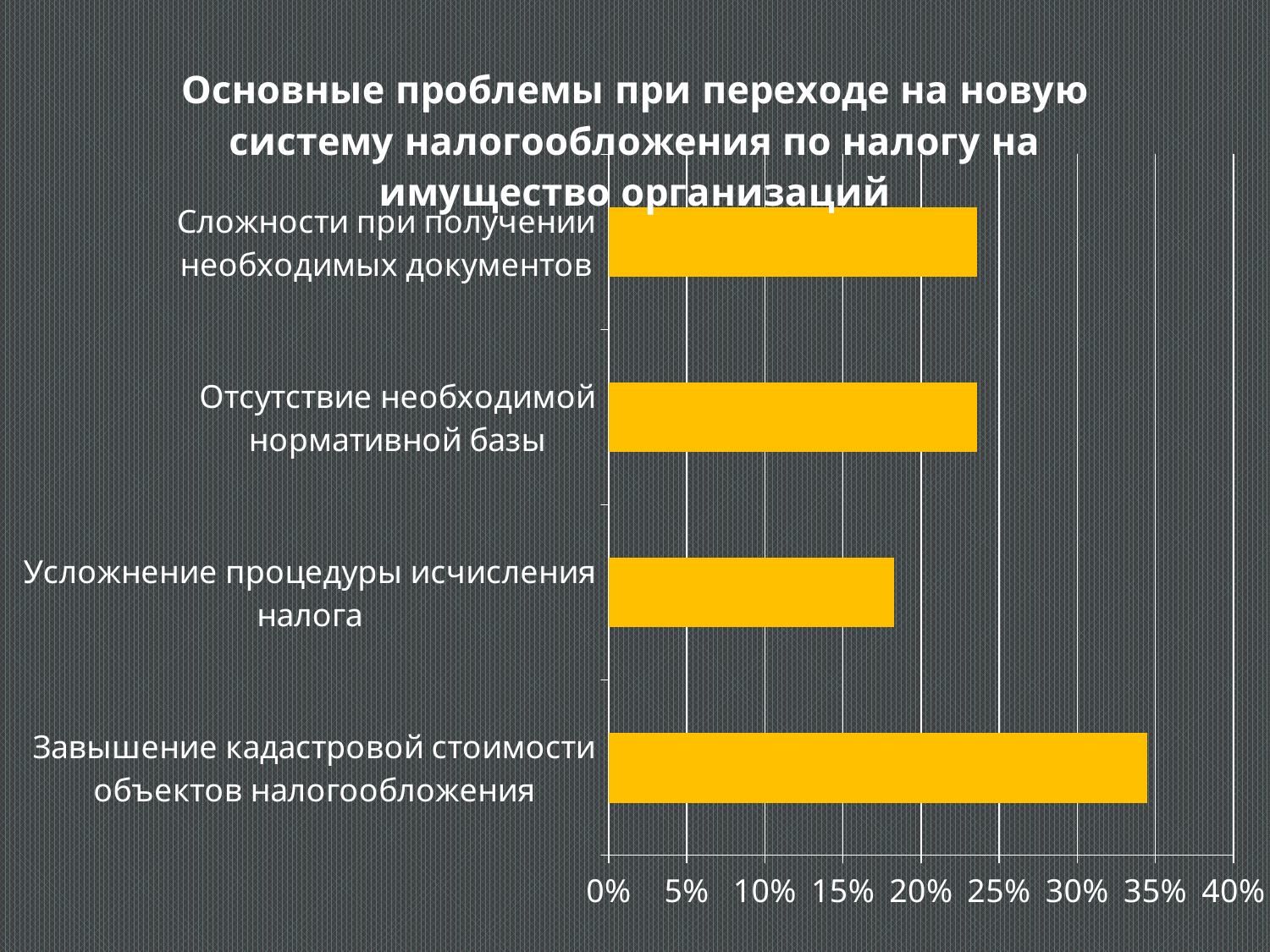
Which is larger: the value for Отсутствие необходимой нормативной базы or the value for Усложнение процедуры исчисления налога? Отсутствие необходимой нормативной базы What kind of chart is shown on the slide? bar chart What is the title of the chart? Основные проблемы при переходе на новую систему налогообложения по налогу на имущество организаций Is the value for Сложности при получении необходимых документов greater or less than 20%? greater Is the value for Усложнение процедуры исчисления налога greater or less than 20%? less Which category has the lowest value? Усложнение процедуры исчисления налога Which is larger: the value for Завышение кадастровой стоимости объектов налогообложения or the value for Усложнение процедуры исчисления налога? Завышение кадастровой стоимости объектов налогообложения How many categories are plotted in the chart? 4 Which category has the highest value? Завышение кадастровой стоимости объектов налогообложения What is the maximum value shown on the horizontal axis? 40% Is the value for Завышение кадастровой стоимости объектов налогообложения greater or less than 30%? greater